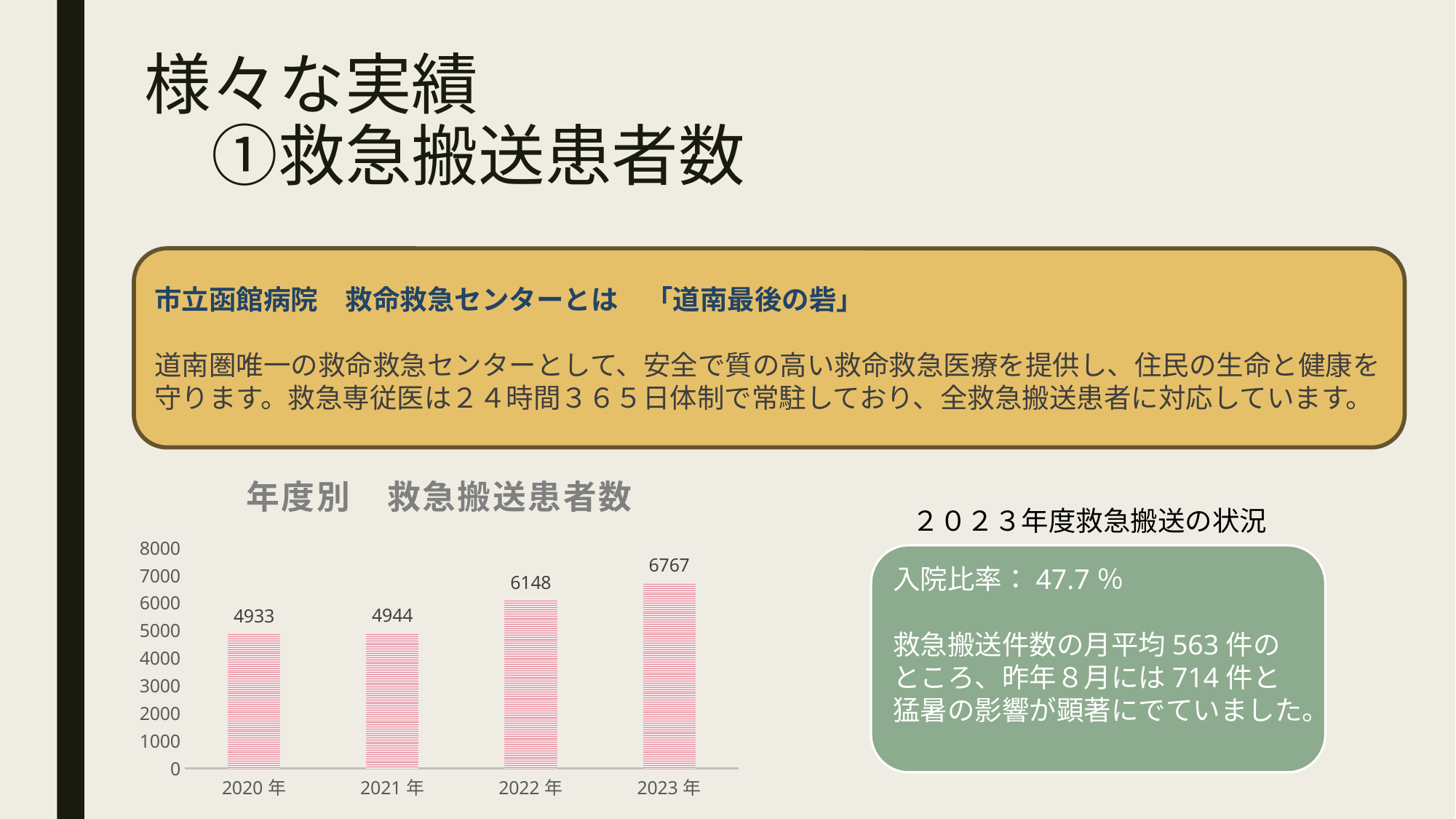
Which year has the highest value in the chart? 2023年 Which year has the lowest value in the chart? 2020年 What is the value for 2021年 in the chart? 4944 What is the title of the chart? 年度別 救急搬送患者数 Which is larger, the value for 2022年 or the value for 2021年? 2022年 What is the value for 2022年 in the chart? 6148 What is the difference between the values for 2023年 and 2022年? 619 What is the value for 2023年 in the chart? 6767 What is the value for 2020年 in the chart? 4933 What is the difference between the values for 2022年 and 2020年? 1215 How many years are shown on the x axis of the chart? 4 What kind of chart is shown on the slide? bar chart